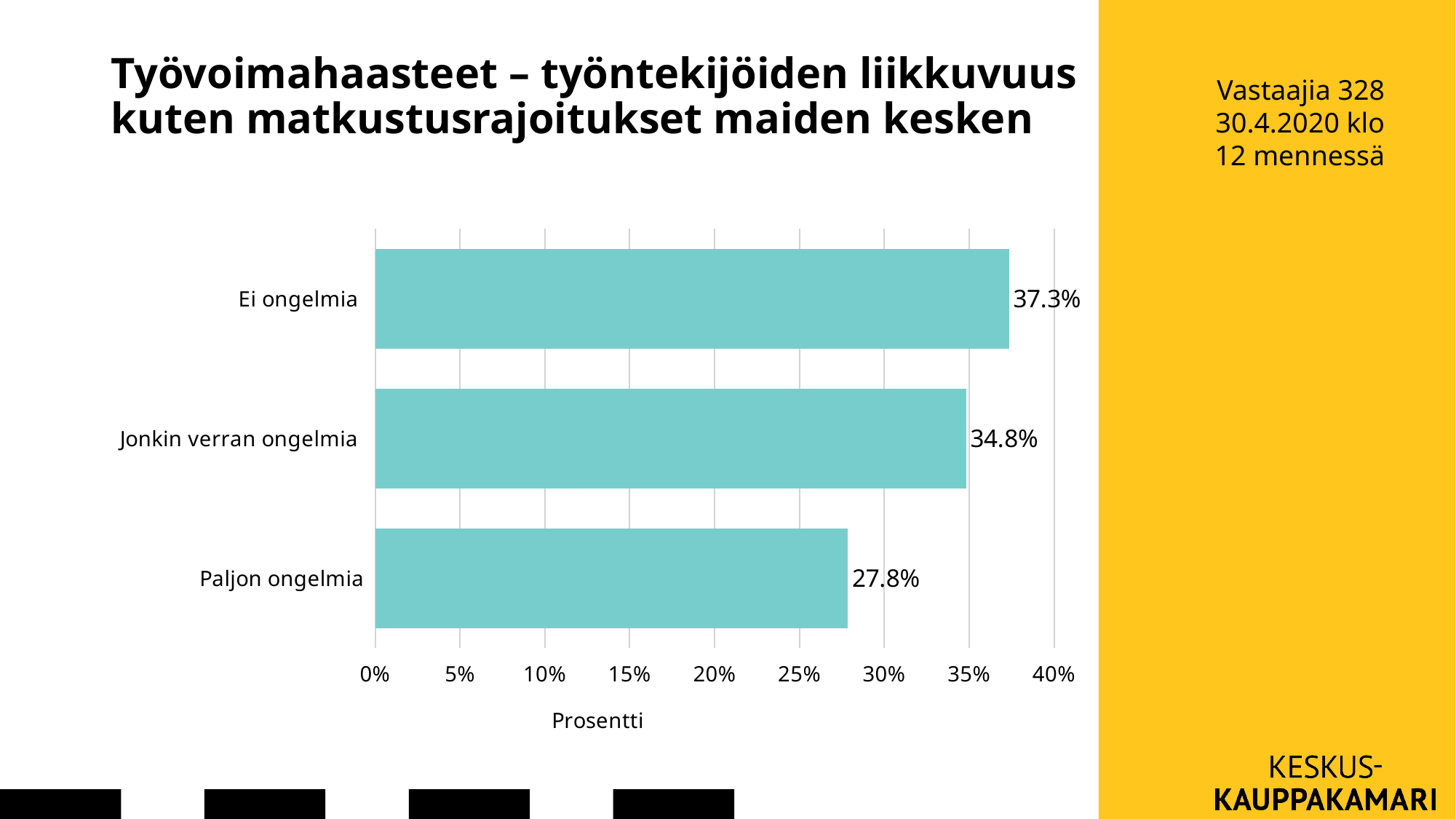
What kind of chart is shown on the slide? bar chart What is the difference between the values for Ei ongelmia and Jonkin verran ongelmia? 2.5% How many categories are shown in the chart? 3 Which category has the lowest value? Paljon ongelmia What is the value for Paljon ongelmia? 27.8% Which is larger, the value for Jonkin verran ongelmia or the value for Paljon ongelmia? Jonkin verran ongelmia What is the value for Ei ongelmia? 37.3% What is the difference between the values for Ei ongelmia and Paljon ongelmia? 9.5% Which category has the highest value? Ei ongelmia What is the label of the horizontal axis? Prosentti What is the value for Jonkin verran ongelmia? 34.8% Is the value for Paljon ongelmia greater or less than 30%? less